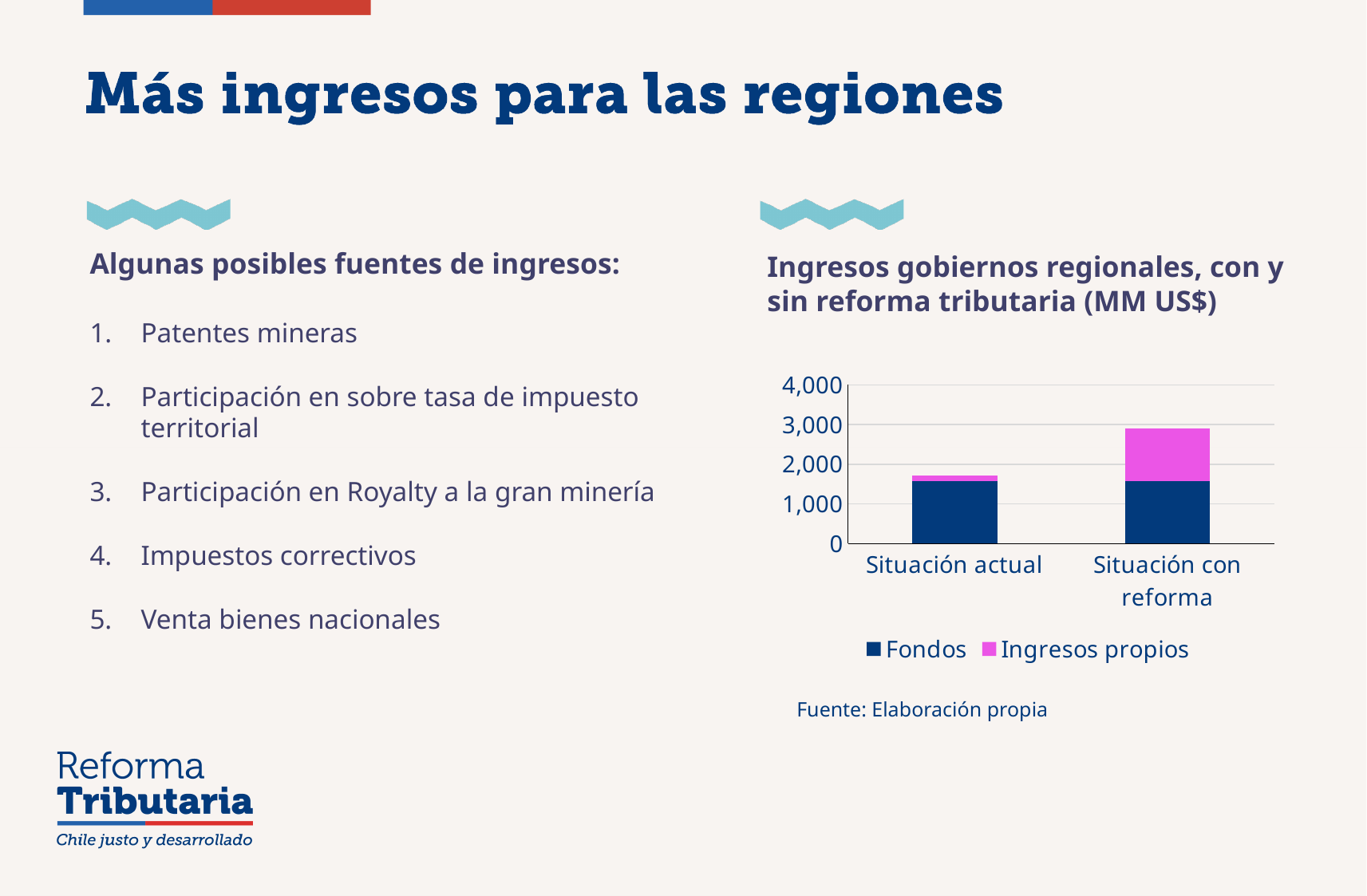
Which category has the larger Ingresos propios value, Situación actual or Situación con reforma? Situación con reforma What is the title of the chart? Ingresos gobiernos regionales, con y sin reforma tributaria (MM US$) How many series does the chart's legend list? 2 What kind of chart is shown on the slide? Stacked bar chart Which category has the higher total stacked bar? Situación con reforma Which series is shown in dark blue in the chart? Fondos Is the Fondos value for Situación actual greater or less than 1,000? greater Which category has the lower total stacked bar? Situación actual Is the total for Situación actual greater or less than 2,000? less Is the total for Situación con reforma greater or less than 2,000? greater How many categories are shown on the x axis of the chart? 2